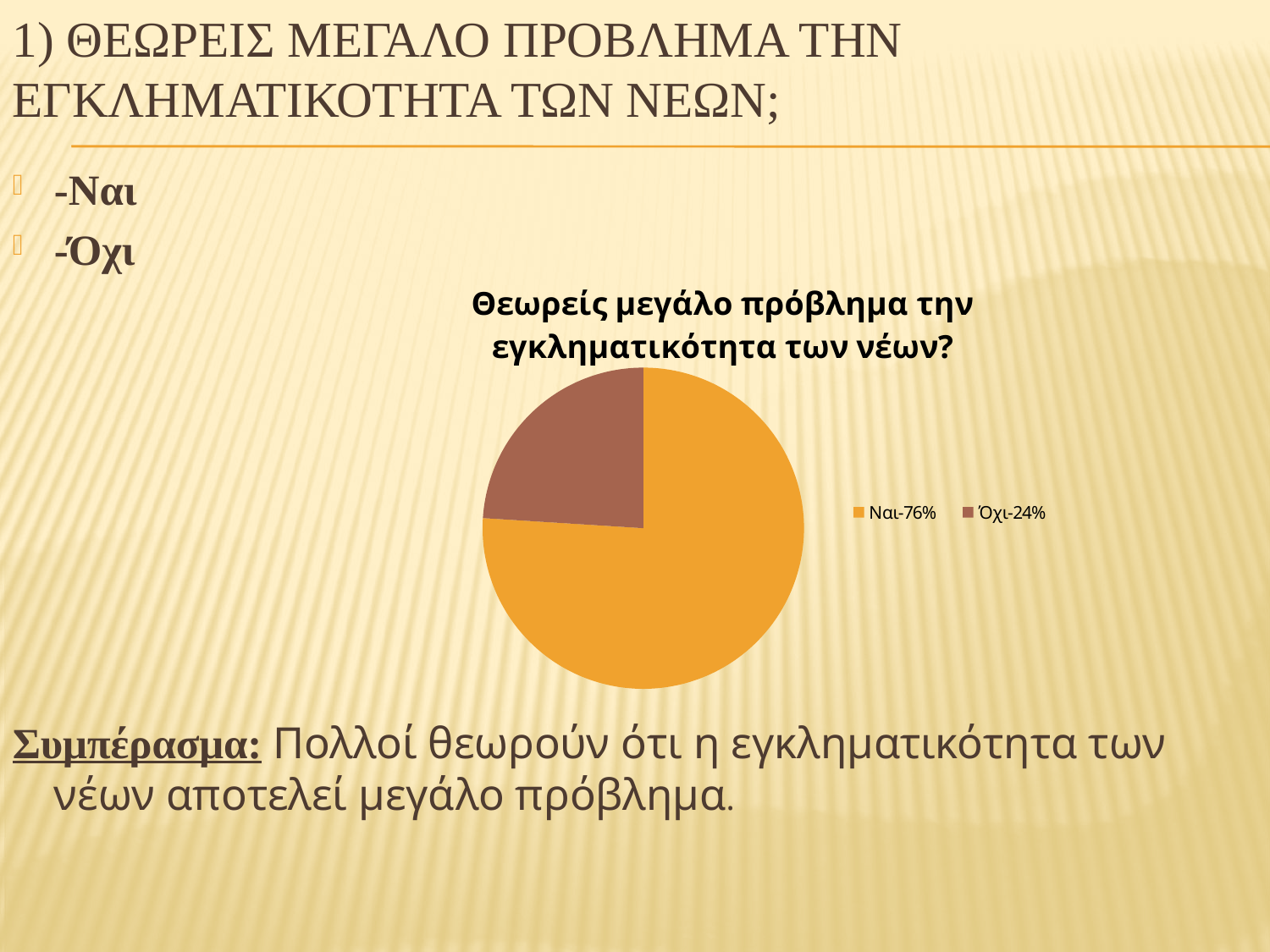
What is the title of the chart? Θεωρείς μεγάλο πρόβλημα την εγκληματικότητα των νέων? What is the difference in percentage points between the Ναι and Όχι slices? 52 What share of the pie does the Ναι slice represent? 76% Which slice is the smallest in the pie chart? Όχι What share of the pie does the Όχι slice represent? 24% Which is larger, the Ναι slice or the Όχι slice? Ναι How many entries does the legend list? 2 What colour is the Ναι slice in the pie chart? orange Which slice is the largest in the pie chart? Ναι How many slices does the pie chart have? 2 What kind of chart is shown on the slide? pie chart